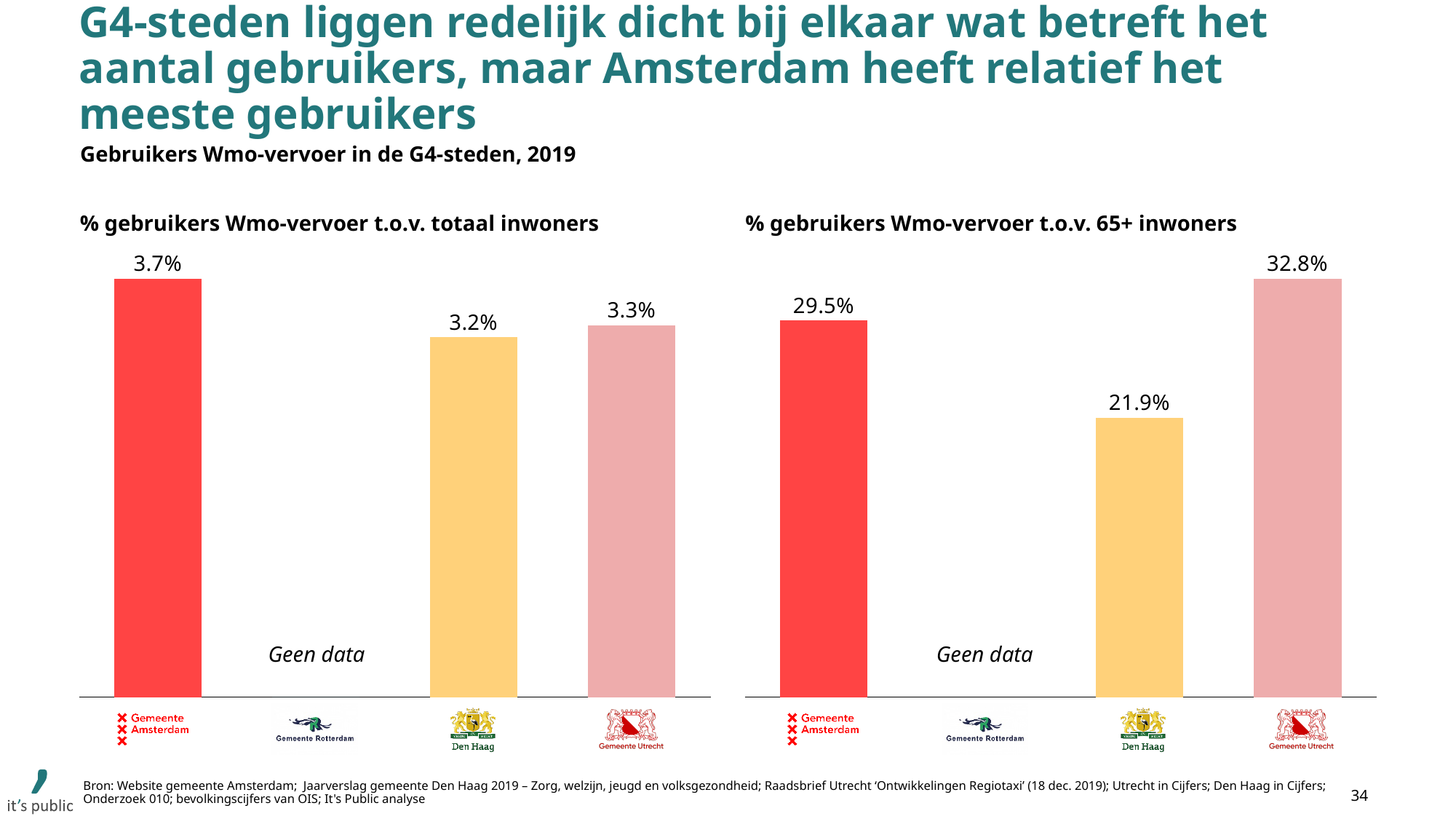
In the right chart (% gebruikers Wmo-vervoer t.o.v. 65+ inwoners), which is larger, Amsterdam or Den Haag? Amsterdam In the left chart (% gebruikers Wmo-vervoer t.o.v. totaal inwoners), which city has no data shown? Rotterdam How many cities are shown on the x axis of the right chart (% gebruikers Wmo-vervoer t.o.v. 65+ inwoners)? 4 In the right chart (% gebruikers Wmo-vervoer t.o.v. 65+ inwoners), what is the value for Den Haag? 21.9% In the right chart (% gebruikers Wmo-vervoer t.o.v. 65+ inwoners), what is the difference between Utrecht and Amsterdam? 3.3% In the left chart (% gebruikers Wmo-vervoer t.o.v. totaal inwoners), what is the value for Den Haag? 3.2% What kind of chart is the left chart (% gebruikers Wmo-vervoer t.o.v. totaal inwoners)? Bar chart In the right chart (% gebruikers Wmo-vervoer t.o.v. 65+ inwoners), which city has the lowest plotted value? Den Haag In the right chart (% gebruikers Wmo-vervoer t.o.v. 65+ inwoners), what is the value for Utrecht? 32.8% In the left chart (% gebruikers Wmo-vervoer t.o.v. totaal inwoners), what is the value for Amsterdam? 3.7% In the left chart (% gebruikers Wmo-vervoer t.o.v. totaal inwoners), what is the difference between Amsterdam and Den Haag? 0.5% In the left chart (% gebruikers Wmo-vervoer t.o.v. totaal inwoners), which city has the highest value? Amsterdam